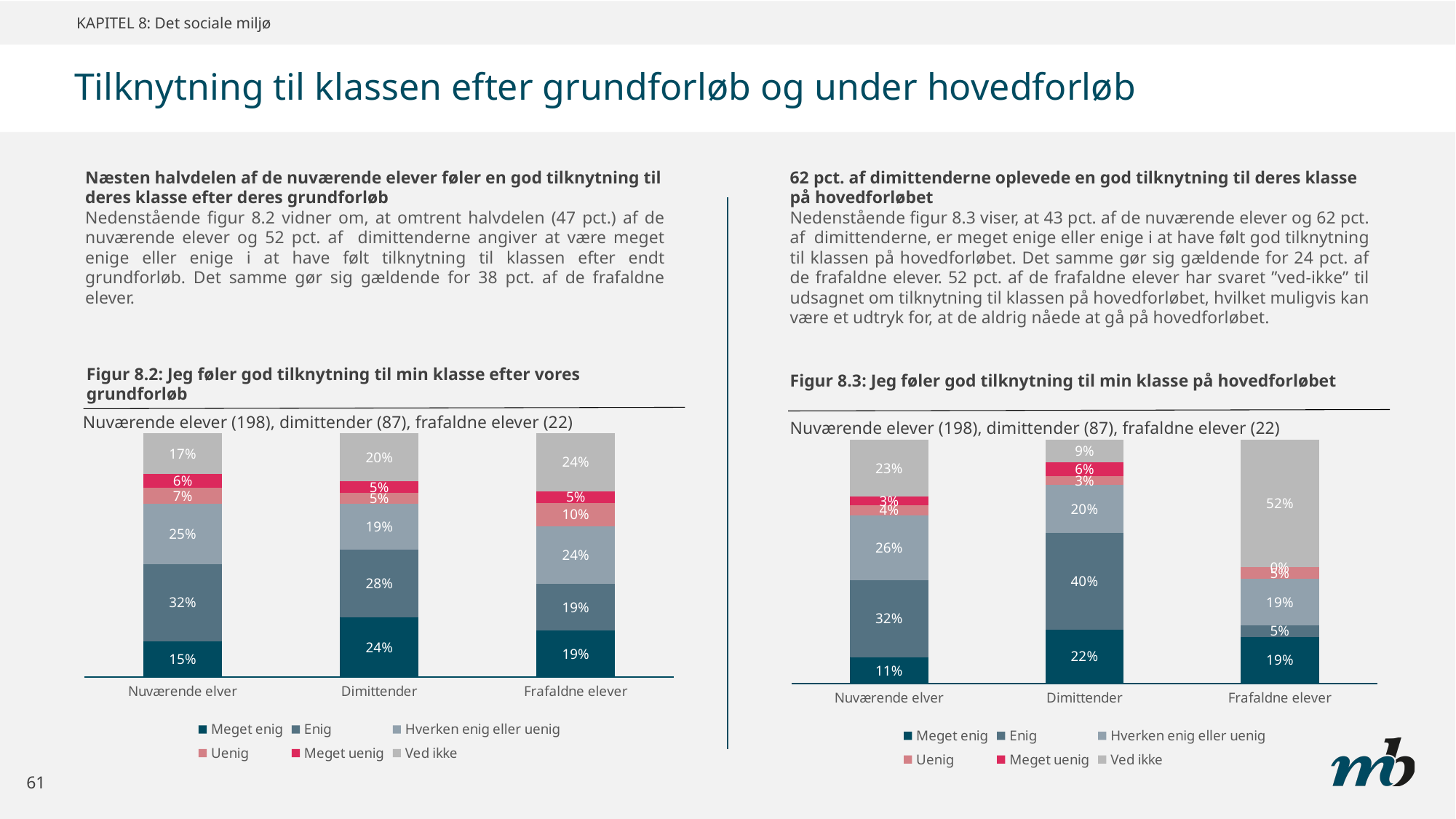
How many series does the legend of Figur 8.3 list? 6 In Figur 8.2, what is the "Ved ikke" share for Frafaldne elever? 24% What type of chart is Figur 8.2? Stacked bar chart In Figur 8.3, what is the difference between the "Ved ikke" shares of Frafaldne elever and Dimittender? 43 percentage points In Figur 8.2, which group has the highest "Enig" share? Nuværende elver In Figur 8.2, what percentage of Dimittender answered "Meget enig"? 24% In Figur 8.3, is the "Hverken enig eller uenig" share larger for Nuværende elever or for Dimittender? Nuværende elever In Figur 8.2, what is the difference between the "Meget enig" shares of Dimittender and Nuværende elver? 9 percentage points In Figur 8.3, which group has the lowest "Meget enig" share? Nuværende elever How many groups are shown on the x axis of Figur 8.2? 3 In Figur 8.3, what is the "Enig" share for Dimittender? 40% In Figur 8.3, what percentage of Frafaldne elever answered "Ved ikke"? 52%